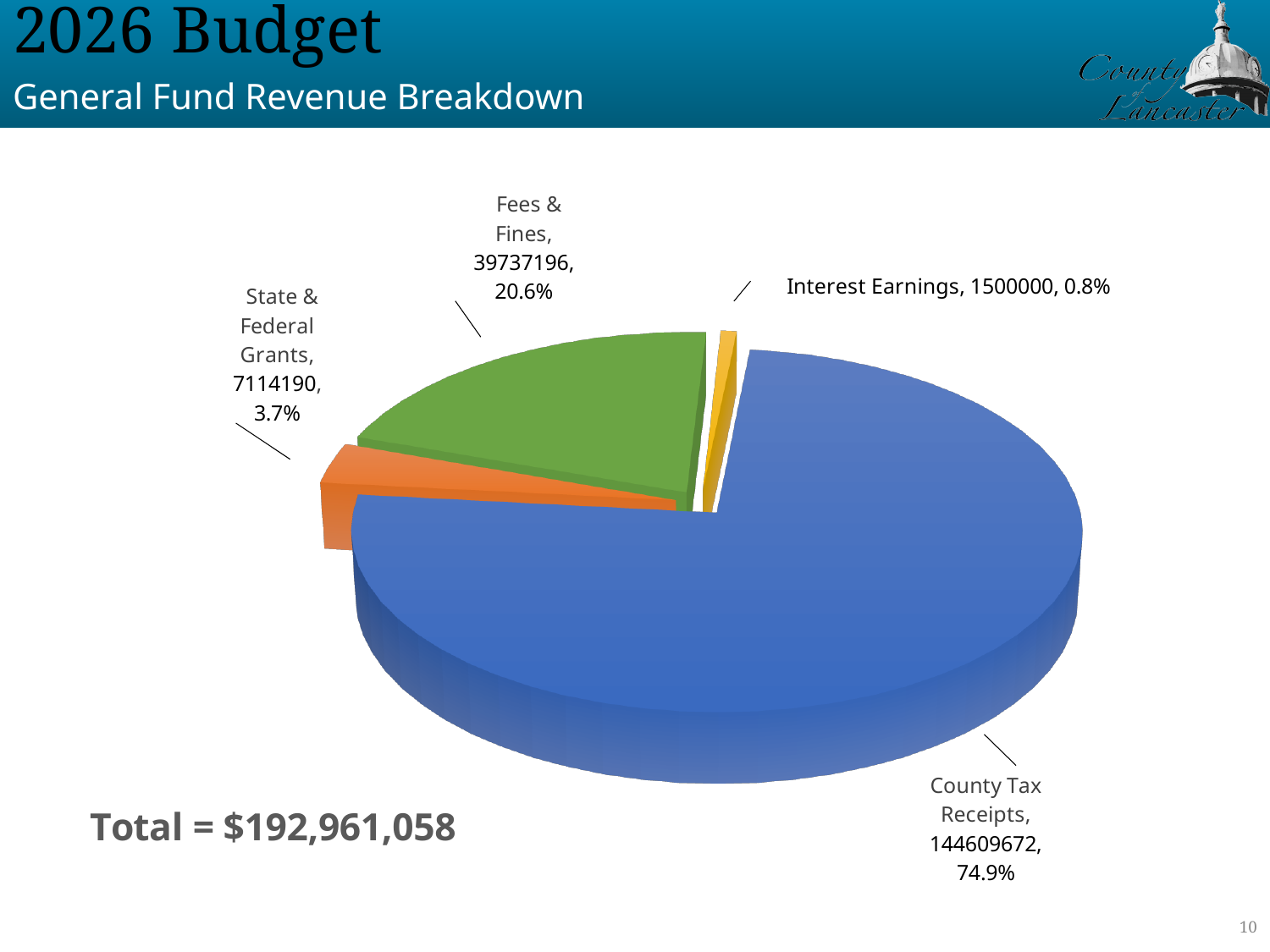
What is the difference between the values for Fees & Fines and State & Federal Grants? 32623006 Which is larger, Fees & Fines or State & Federal Grants? Fees & Fines What share of the pie does Fees & Fines represent? 20.6% How many slices does the pie chart have? 4 What is the value for State & Federal Grants? 7114190 What share of the pie does County Tax Receipts represent? 74.9% Which category has the largest slice? County Tax Receipts What is the value for County Tax Receipts? 144609672 What kind of chart is shown on the slide? Pie chart What is the value for Interest Earnings? 1500000 What is the value for Fees & Fines? 39737196 Which category has the smallest slice? Interest Earnings